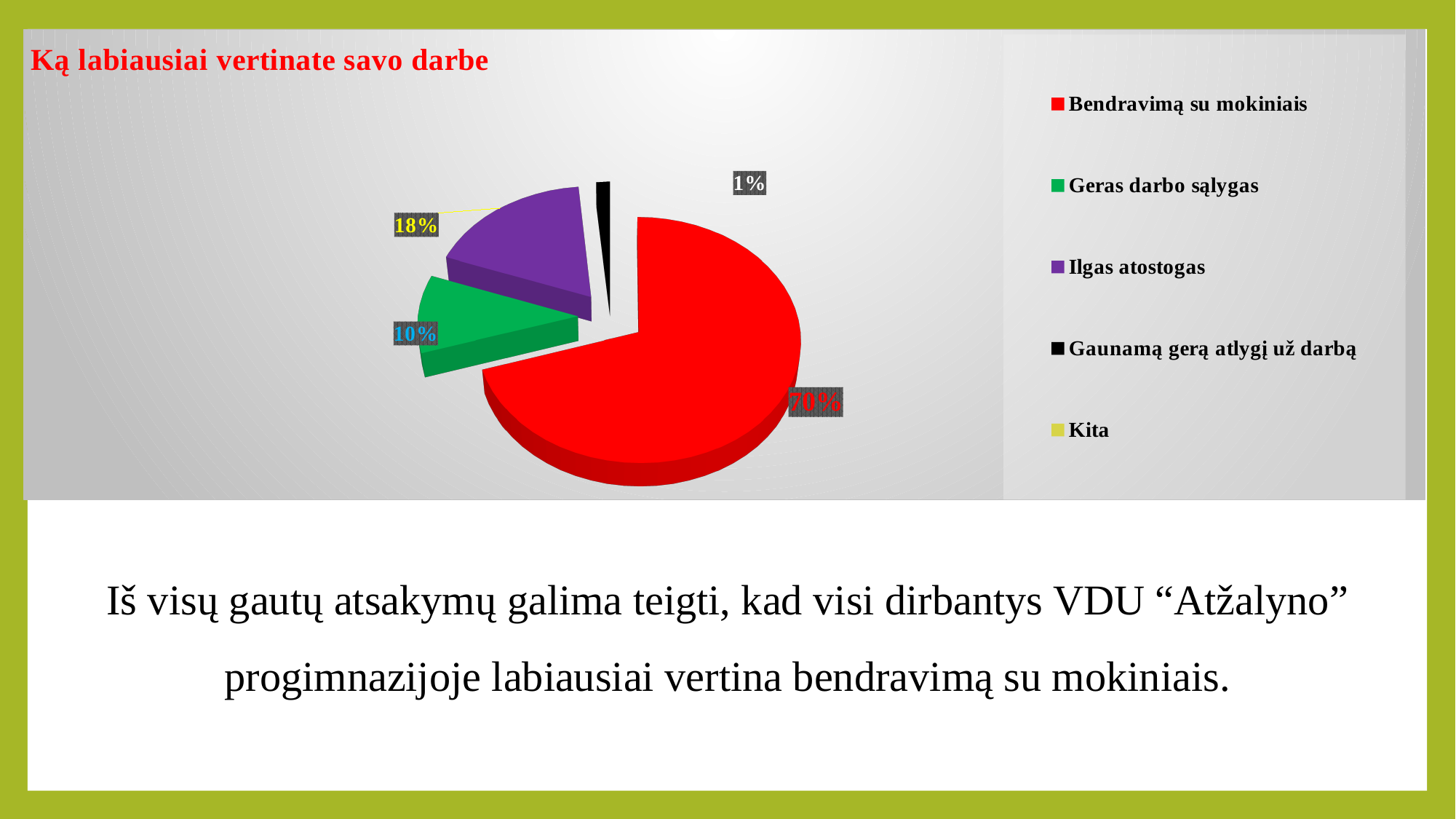
How many entries does the legend list? 5 What percentage is shown for "Geras darbo sąlygas"? 10% What is the title of the chart? Ką labiausiai vertinate savo darbe Which is larger, the slice for "Ilgas atostogas" or the slice for "Geras darbo sąlygas"? Ilgas atostogas What is the difference in percentage points between "Ilgas atostogas" and "Geras darbo sąlygas"? 8 percentage points What is the difference in percentage points between "Bendravimą su mokiniais" and "Ilgas atostogas"? 52 percentage points What percentage is shown for "Bendravimą su mokiniais"? 70% Which category has the largest slice of the pie? Bendravimą su mokiniais What kind of chart is shown on the slide? Pie chart What colour represents "Ilgas atostogas" in the chart? Purple What percentage is shown for "Ilgas atostogas"? 18% What percentage is shown for "Gaunamą gerą atlygį už darbą"? 1%